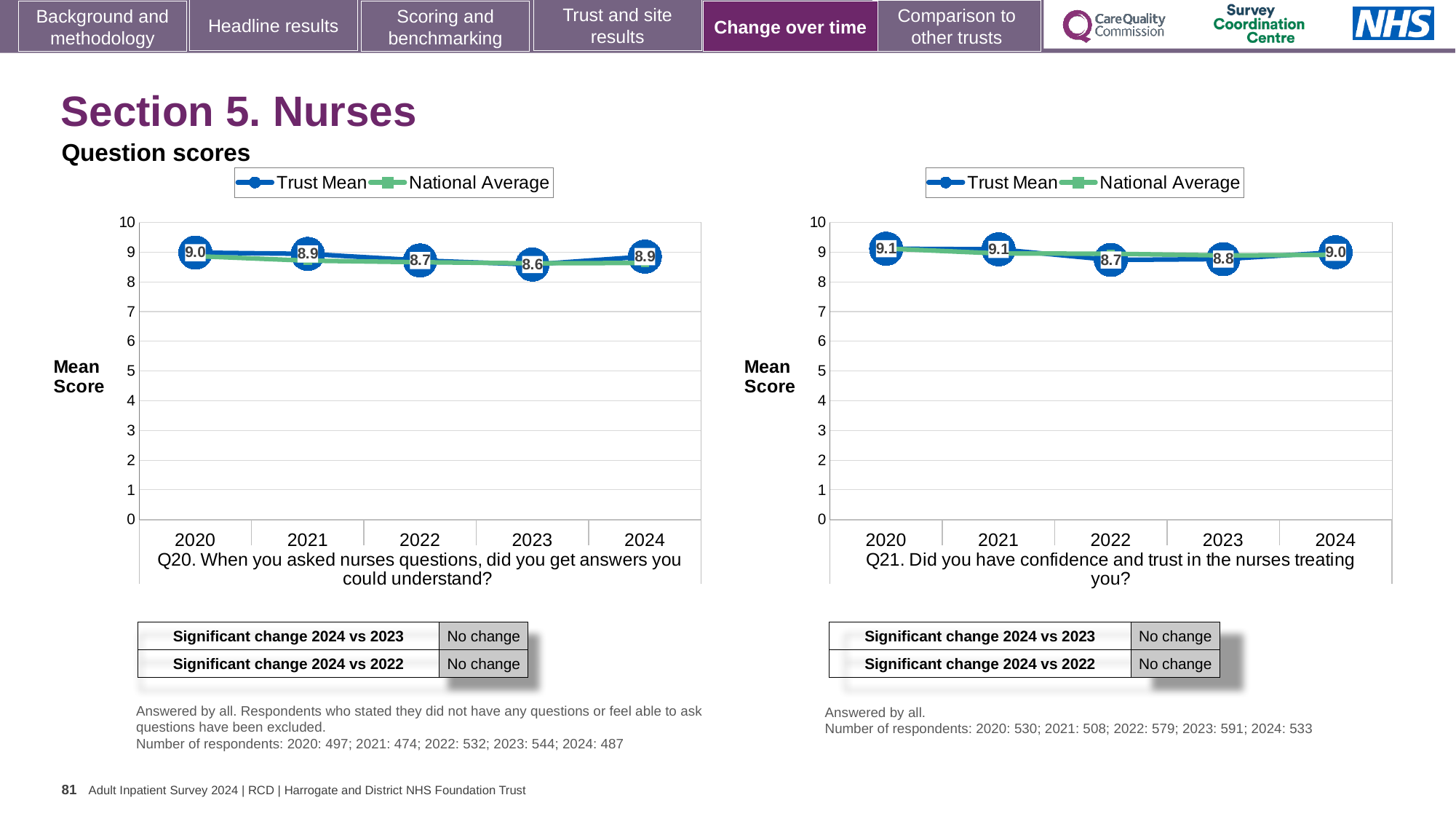
On the Q21 chart (right), what is the difference between the Trust Mean score in 2020 and in 2022? 0.4 On the Q20 chart (left), what is the Trust Mean score for 2020? 9.0 On the Q20 chart (left), which year has the lowest Trust Mean score? 2023 On the Q20 chart (left), is the Trust Mean score higher in 2024 or in 2023? 2024 How many years are plotted on the x axis of the Q20 chart (left)? 5 What type of chart is used for Q20 (left)? Line chart On the Q21 chart (right), what is the Trust Mean score for 2022? 8.7 On the Q21 chart (right), what is the Trust Mean score for 2024? 9.0 On the Q20 chart (left), what is the Trust Mean score for 2023? 8.6 On the Q20 chart (left), which year has the highest Trust Mean score? 2020 On the Q21 chart (right), is the Trust Mean value for 2023 greater or less than 8? greater How many series does the legend of the Q21 chart (right) list? 2